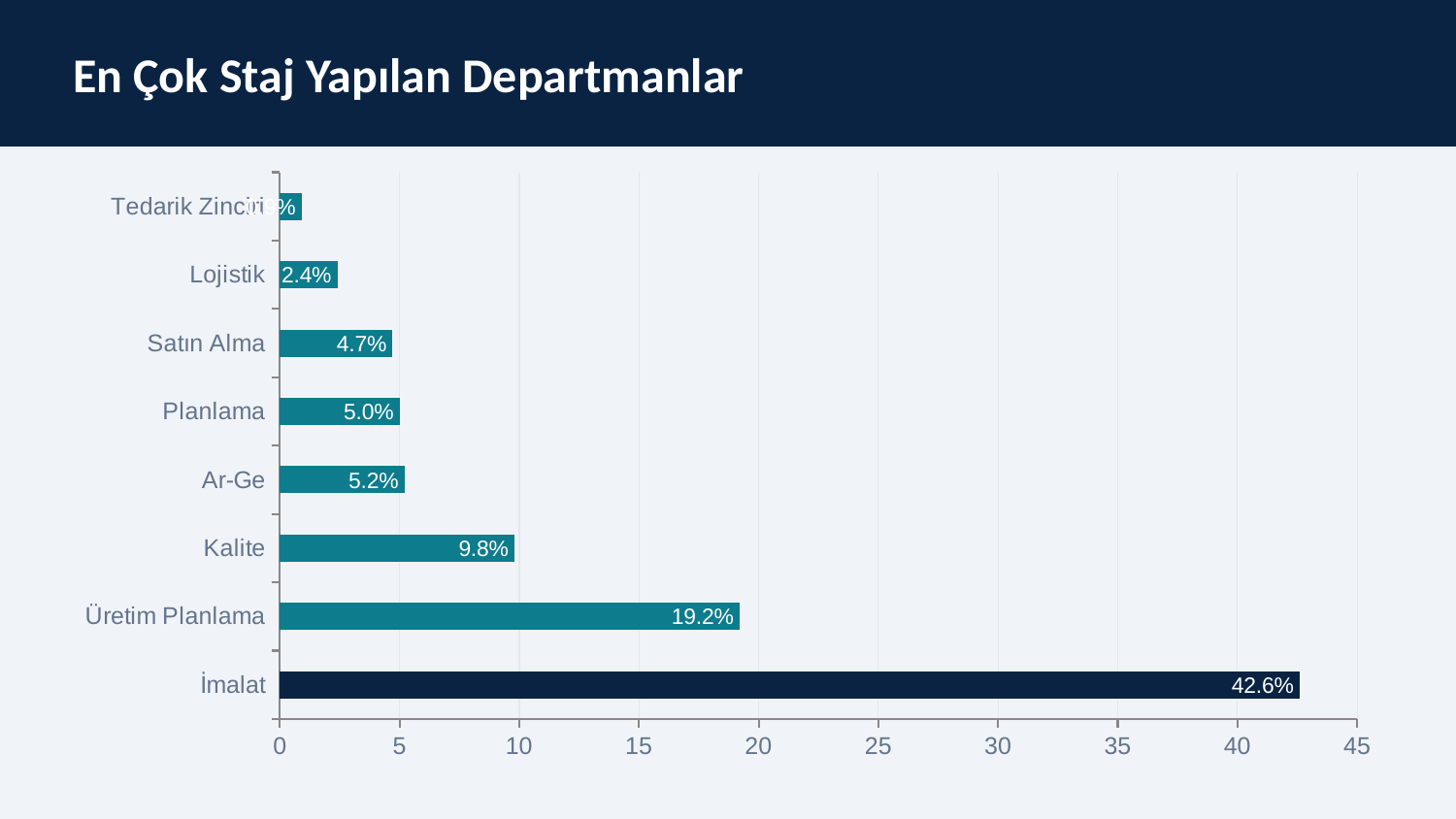
Which department has the highest value? İmalat What is the value for Kalite? 9.8% What is the value for Üretim Planlama? 19.2% Which is larger, the value for Kalite or the value for Ar-Ge? Kalite What is the value for Lojistik? 2.4% What is the difference between the values for İmalat and Üretim Planlama? 23.4 percentage points What kind of chart is shown on the slide? Bar chart What is the difference between the values for Kalite and Satın Alma? 5.1 percentage points What is the value for İmalat? 42.6% How many departments are shown in the chart? 8 Which department has the lowest value? Tedarik Zinciri Is the value for İmalat greater or less than 40? greater